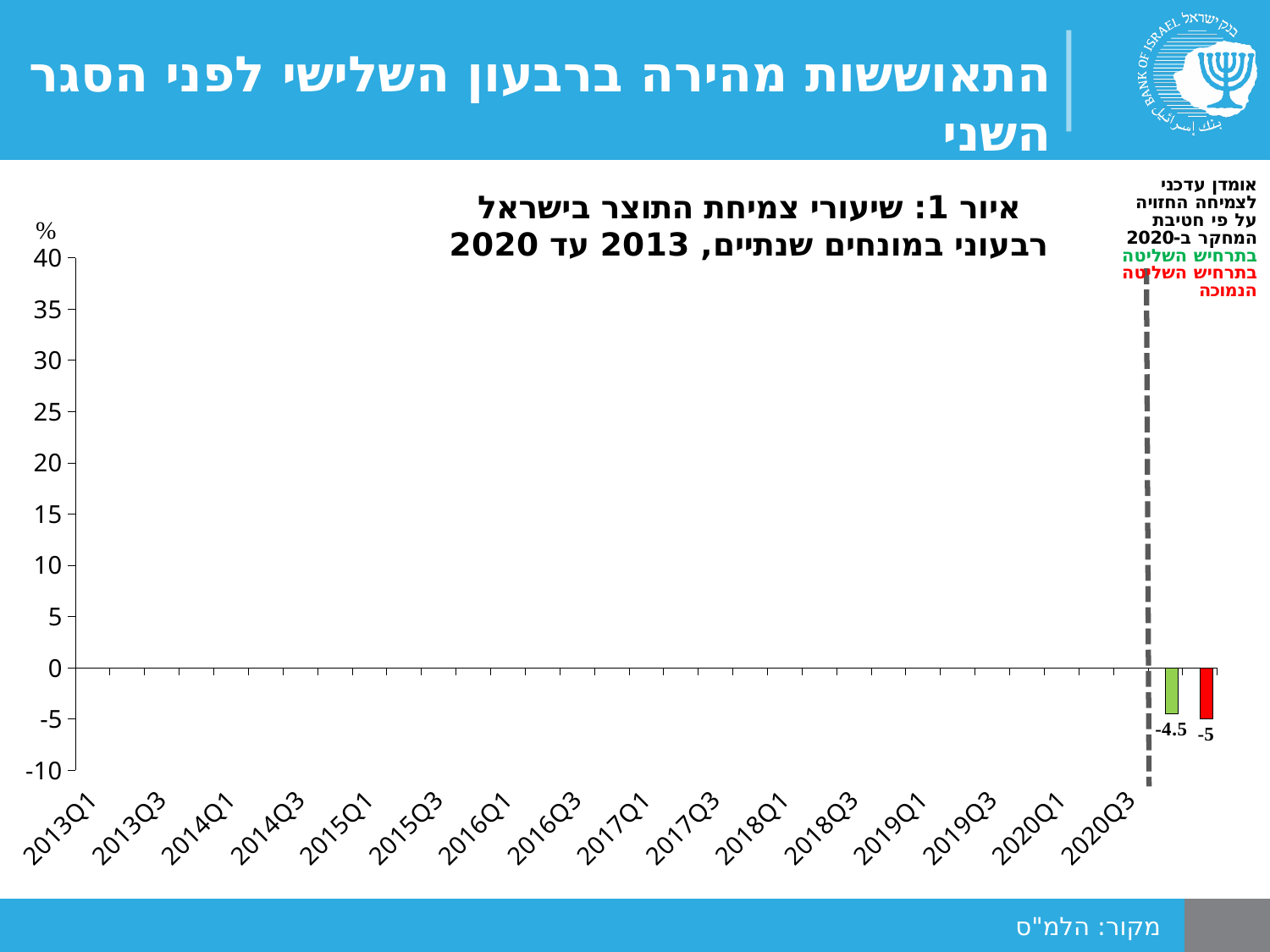
Which of the two labelled bars has the lower value, the green one or the red one? the red one (-5) How many bars with data labels are plotted on the chart? 2 According to the annotation, which scenario does the red bar represent? בתרחיש השליטה הנמוכה What is the difference between the green bar's value (-4.5) and the red bar's value (-5)? 0.5 Is the value of the green bar greater or less than 0? less What is the last category label on the horizontal axis? 2020Q3 What value is printed on the red bar at the right of the chart? -5 What kind of chart is shown on the slide? bar chart What is the lowest value shown on the vertical axis? -10 What value is printed on the green bar at the right of the chart? -4.5 What is the highest value shown on the vertical axis? 40 What is the first category label on the horizontal axis? 2013Q1